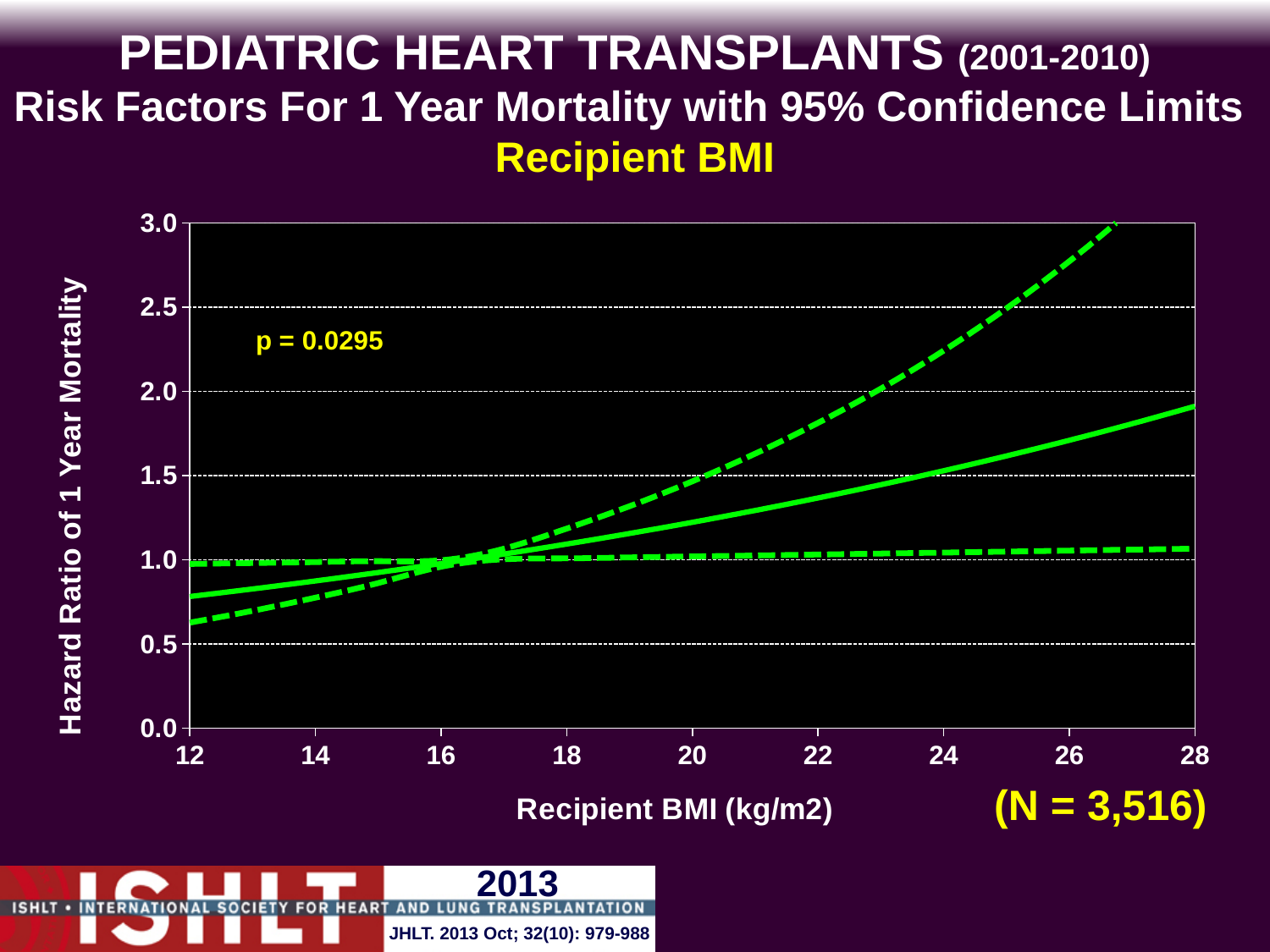
Is the value of the lower dashed confidence limit at a recipient BMI of 12 greater or less than 0.5? greater Is the value of the solid hazard ratio line at a recipient BMI of 20 greater or less than 1.5? less Does the solid hazard ratio line rise or fall as recipient BMI increases from 12 to 28? rise Is the value of the upper dashed confidence limit at a recipient BMI of 22 greater or less than 1.5? greater What kind of chart is shown on the slide? line chart What sample size (N) is printed on the slide? N = 3,516 What p-value is printed on the chart? p = 0.0295 Which is larger at a recipient BMI of 28: the upper dashed confidence limit or the solid hazard ratio line? the upper dashed confidence limit How many lines are plotted on the chart? 3